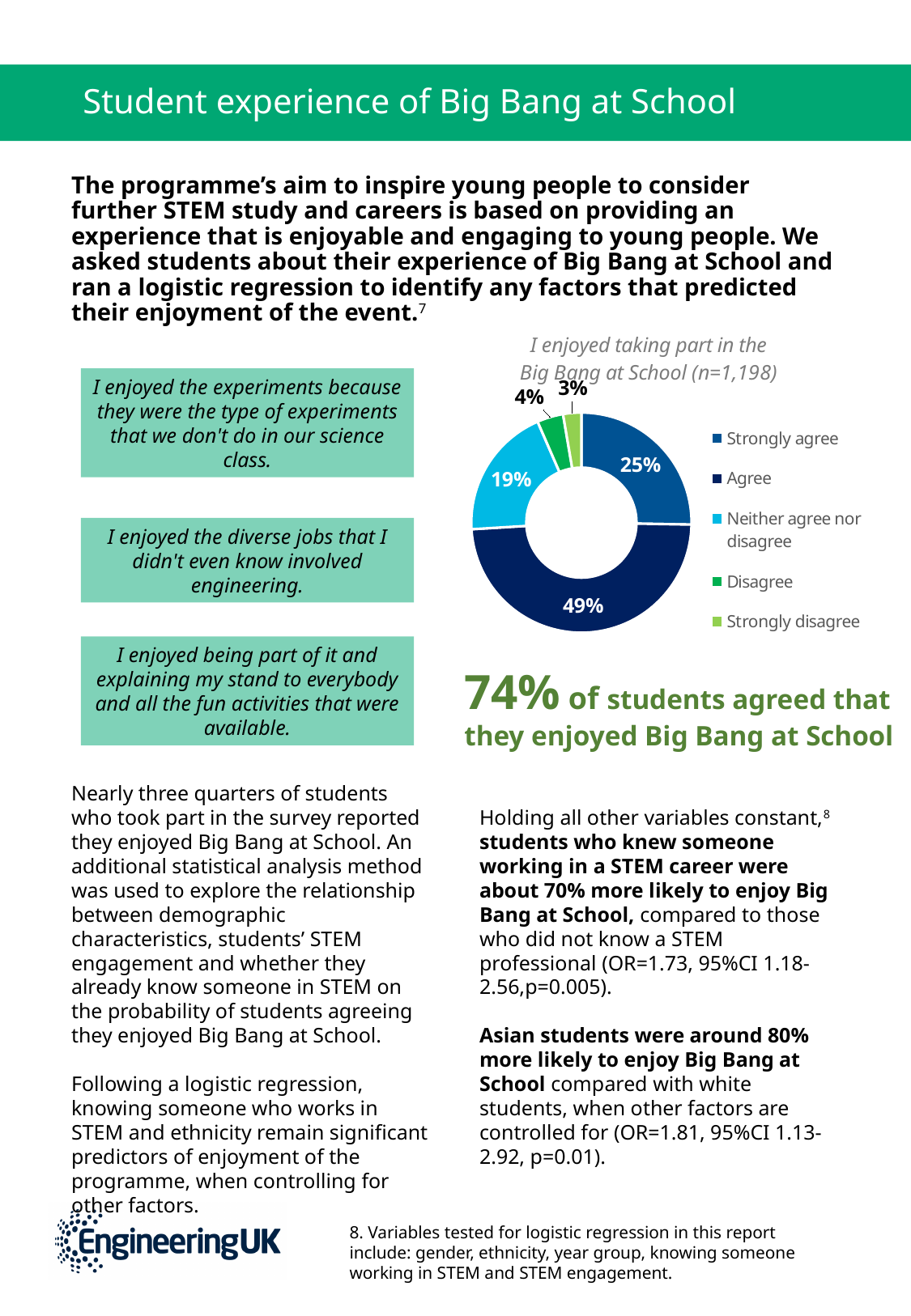
What percentage of students selected 'Agree' in the chart 'I enjoyed taking part in the Big Bang at School'? 49% What is the sample size (n) given in the chart title? 1,198 Which is larger: the share for 'Neither agree nor disagree' or the share for 'Disagree'? Neither agree nor disagree Which response category has the largest share in the chart? Agree What type of chart is used to show students' enjoyment of Big Bang at School? Donut (pie) chart What share of the chart is 'Neither agree nor disagree'? 19% What percentage of students selected 'Strongly disagree'? 3% What percentage of students selected 'Strongly agree' in the chart? 25% How many response categories does the chart's legend list? 5 What is the difference in percentage points between 'Agree' and 'Strongly agree'? 24 Which response category has the smallest share in the chart? Strongly disagree What is the combined share of 'Strongly agree' and 'Agree'? 74%